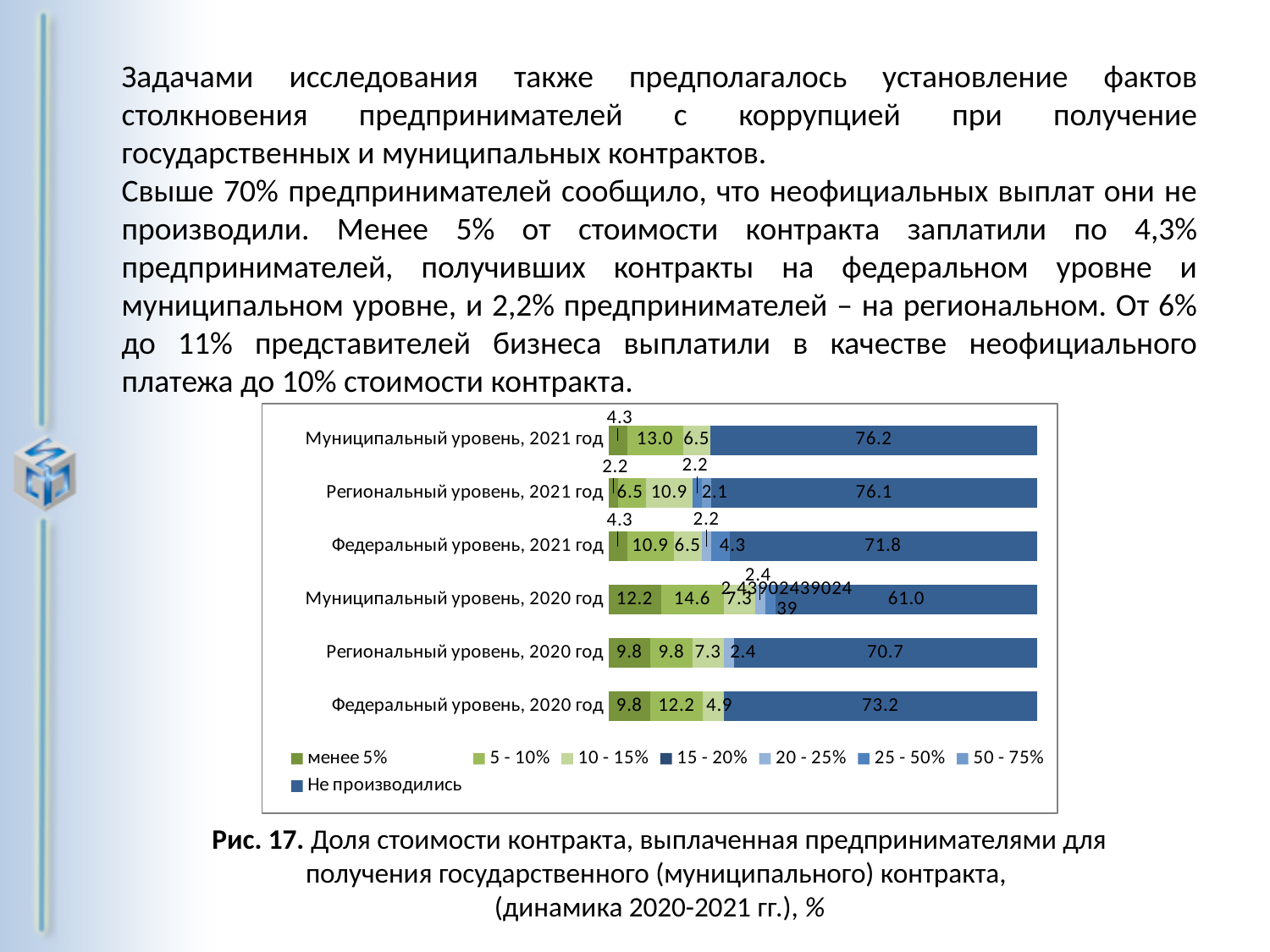
What is the difference between the "Не производились" values for "Муниципальный уровень, 2021 год" and "Муниципальный уровень, 2020 год"? 15.2 What kind of chart is shown on the slide? Stacked bar chart What is the value of "5 - 10%" for "Муниципальный уровень, 2021 год"? 13.0 What is the value of "Не производились" for "Федеральный уровень, 2020 год"? 73.2 Which is larger for "Не производились": "Федеральный уровень, 2021 год" or "Федеральный уровень, 2020 год"? Федеральный уровень, 2020 год Which category has the lowest value for "Не производились"? Муниципальный уровень, 2020 год How many series does the legend list? 8 How many categories (bars) does the chart show? 6 What is the value of "Не производились" for "Муниципальный уровень, 2021 год"? 76.2 What is the last entry listed in the chart legend? Не производились What is the value of "Не производились" for "Муниципальный уровень, 2020 год"? 61.0 What is the value of "менее 5%" for "Муниципальный уровень, 2020 год"? 12.2